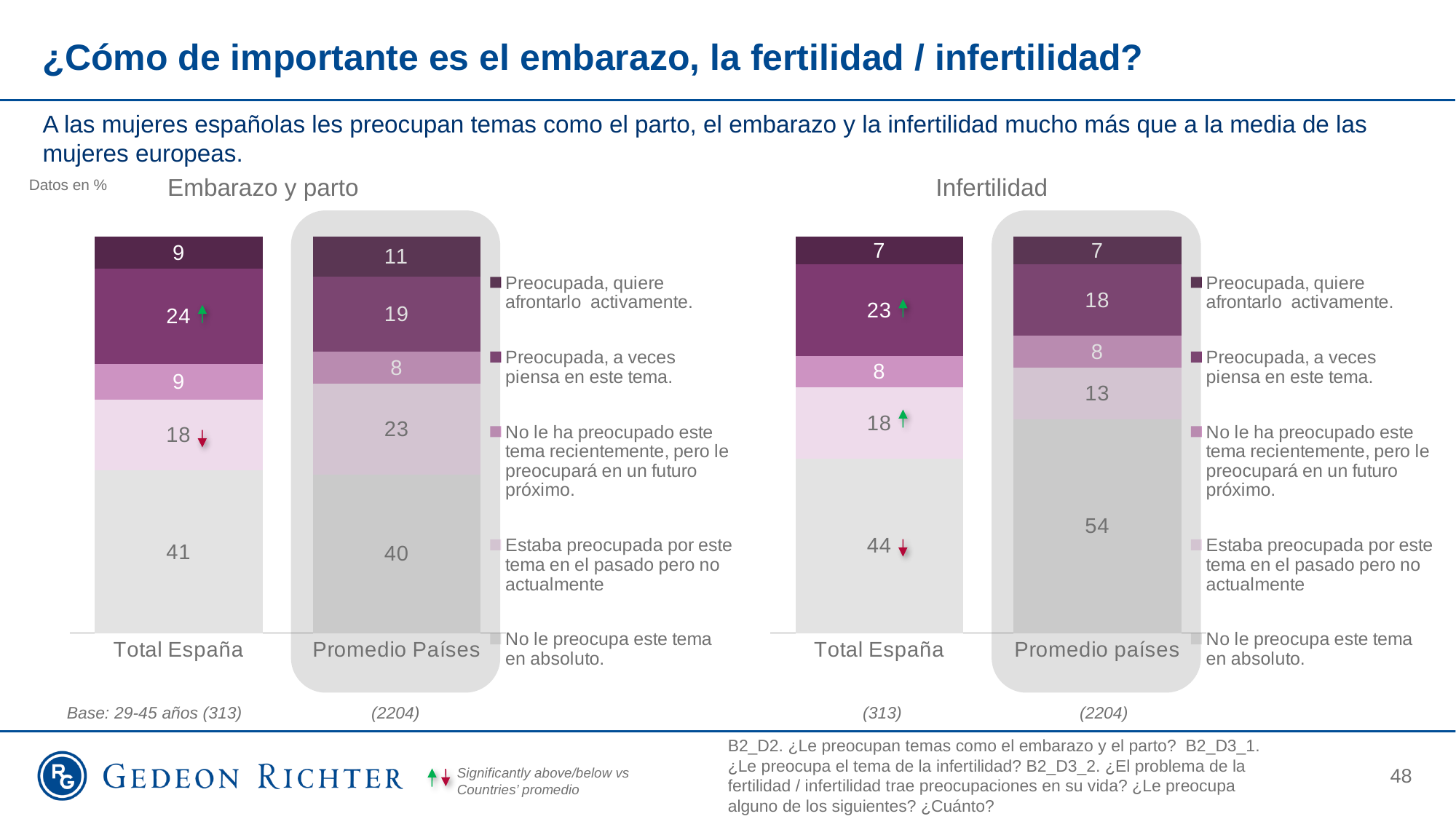
In the 'Infertilidad' chart, what is the value for 'Preocupada, a veces piensa en este tema' for Total España? 23 How many series does the legend of the 'Infertilidad' chart list? 5 In the 'Infertilidad' chart, what is the difference between Promedio países and Total España for 'No le preocupa este tema en absoluto'? 10 What type of chart is the 'Embarazo y parto' chart? Stacked bar chart How many bars are in the 'Embarazo y parto' chart? 2 In the 'Embarazo y parto' chart, which is larger for 'Preocupada, a veces piensa en este tema': Total España or Promedio Países? Total España In the 'Embarazo y parto' chart, what is the value for 'Preocupada, quiere afrontarlo activamente' for Promedio Países? 11 In the 'Embarazo y parto' chart, what is the value for 'No le preocupa este tema en absoluto' for Total España? 41 In the 'Infertilidad' chart, which segment is the smallest in the Total España bar? Preocupada, quiere afrontarlo activamente In the 'Infertilidad' chart, which is larger for 'Estaba preocupada por este tema en el pasado pero no actualmente': Total España or Promedio países? Total España In the 'Infertilidad' chart, what is the value for 'No le preocupa este tema en absoluto' for Promedio países? 54 In the 'Embarazo y parto' chart, which segment is the largest in the Total España bar? No le preocupa este tema en absoluto